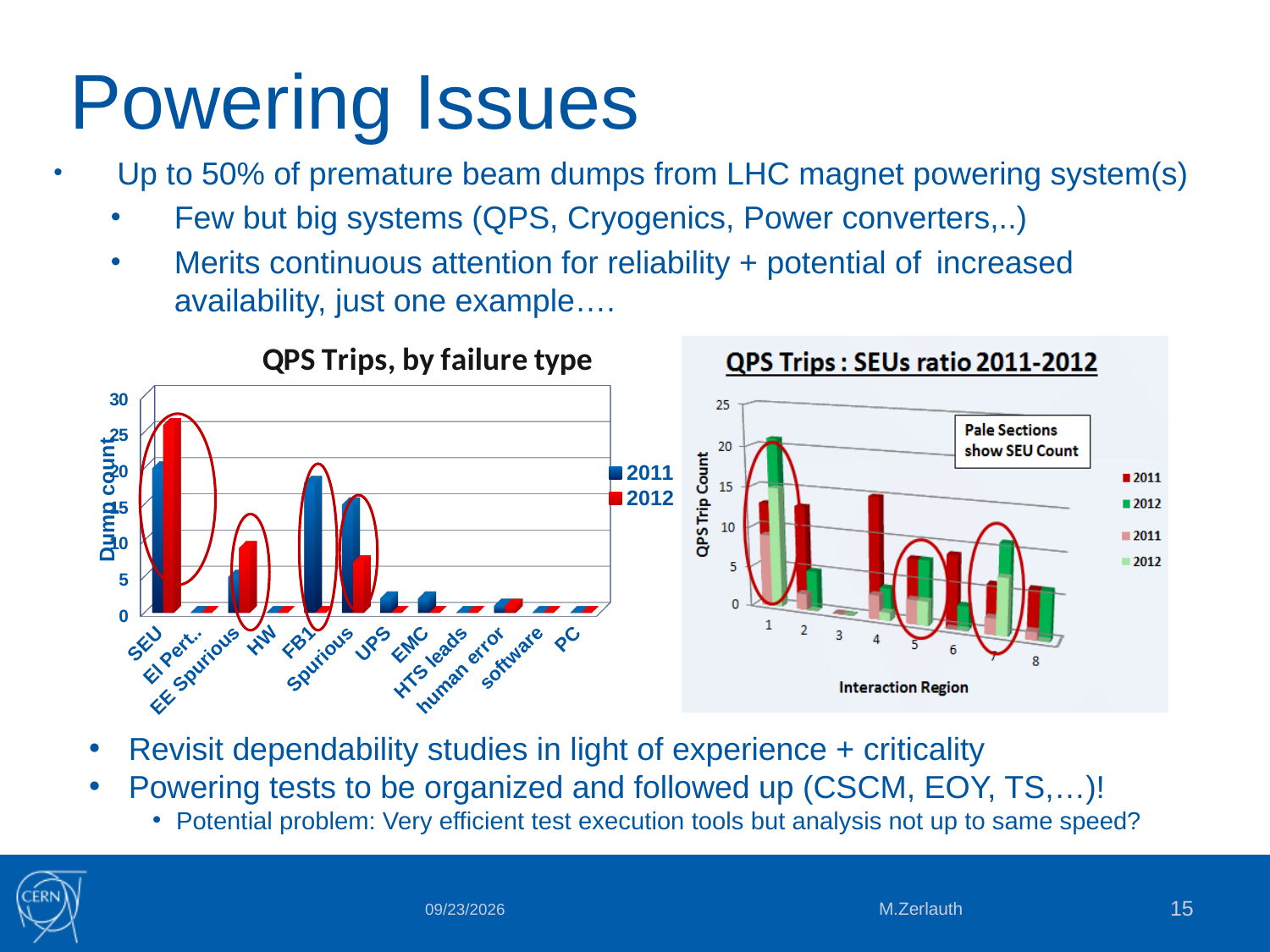
In the 'QPS Trips, by failure type' chart, which is larger for SEU: the 2011 value or the 2012 value? 2012 In the 'QPS Trips : SEUs ratio 2011-2012' chart, is the 2012 QPS trip count for interaction region 1 greater or less than 15? greater How many interaction regions are shown on the x axis of the 'QPS Trips : SEUs ratio 2011-2012' chart? 8 What is the y-axis label of the 'QPS Trips, by failure type' chart? Dump count How many series does the legend of the 'QPS Trips, by failure type' chart list? 2 In the 'QPS Trips, by failure type' chart, is the 2011 value for FB1 greater or less than 20? less How many failure-type categories are shown on the x axis of the 'QPS Trips, by failure type' chart? 12 How many entries does the legend of the 'QPS Trips : SEUs ratio 2011-2012' chart list? 4 What kind of chart is the 'QPS Trips, by failure type' chart? bar chart In the 'QPS Trips, by failure type' chart, is the 2012 value for SEU greater or less than 25? greater In the 'QPS Trips, by failure type' chart, which is larger for FB1: the 2011 value or the 2012 value? 2011 In the 'QPS Trips, by failure type' chart, which failure type has the highest 2012 dump count? SEU